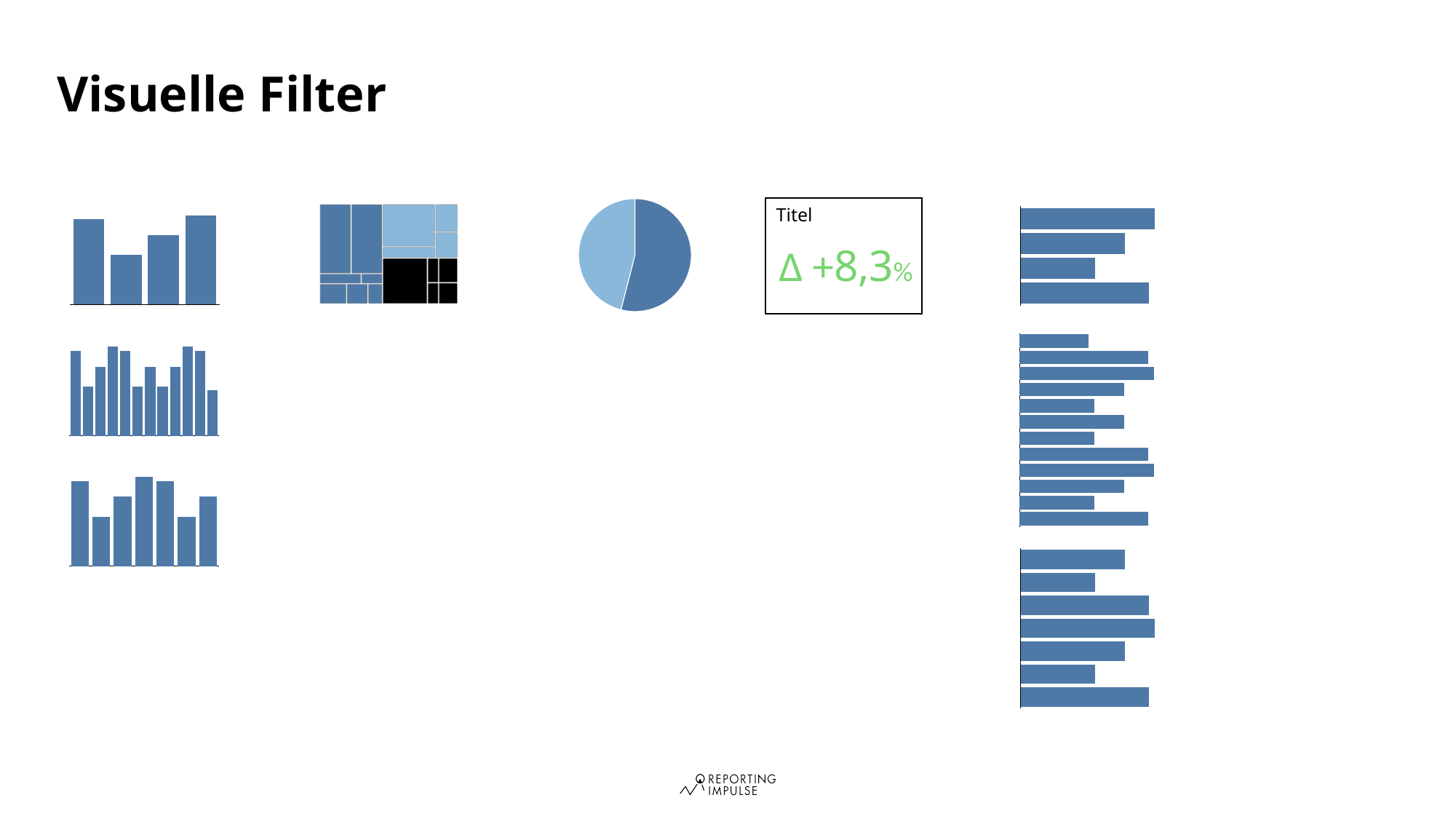
How many bars does the top-left bar chart have? 4 In the top-left bar chart, which bar is the shortest, counting from the left? the second What is the title of the slide? Visuelle Filter What kind of chart is shown in the centre of the slide, to the right of the treemap? pie chart How many bars does the topmost horizontal bar chart on the right side of the slide have? 4 How many bars does the middle-left bar chart have? 12 What kind of chart is shown at the top left of the slide? bar chart In the top-left bar chart, which bar is the tallest, counting from the left? the fourth What value is displayed in the KPI box labelled 'Titel'? Δ +8,3%